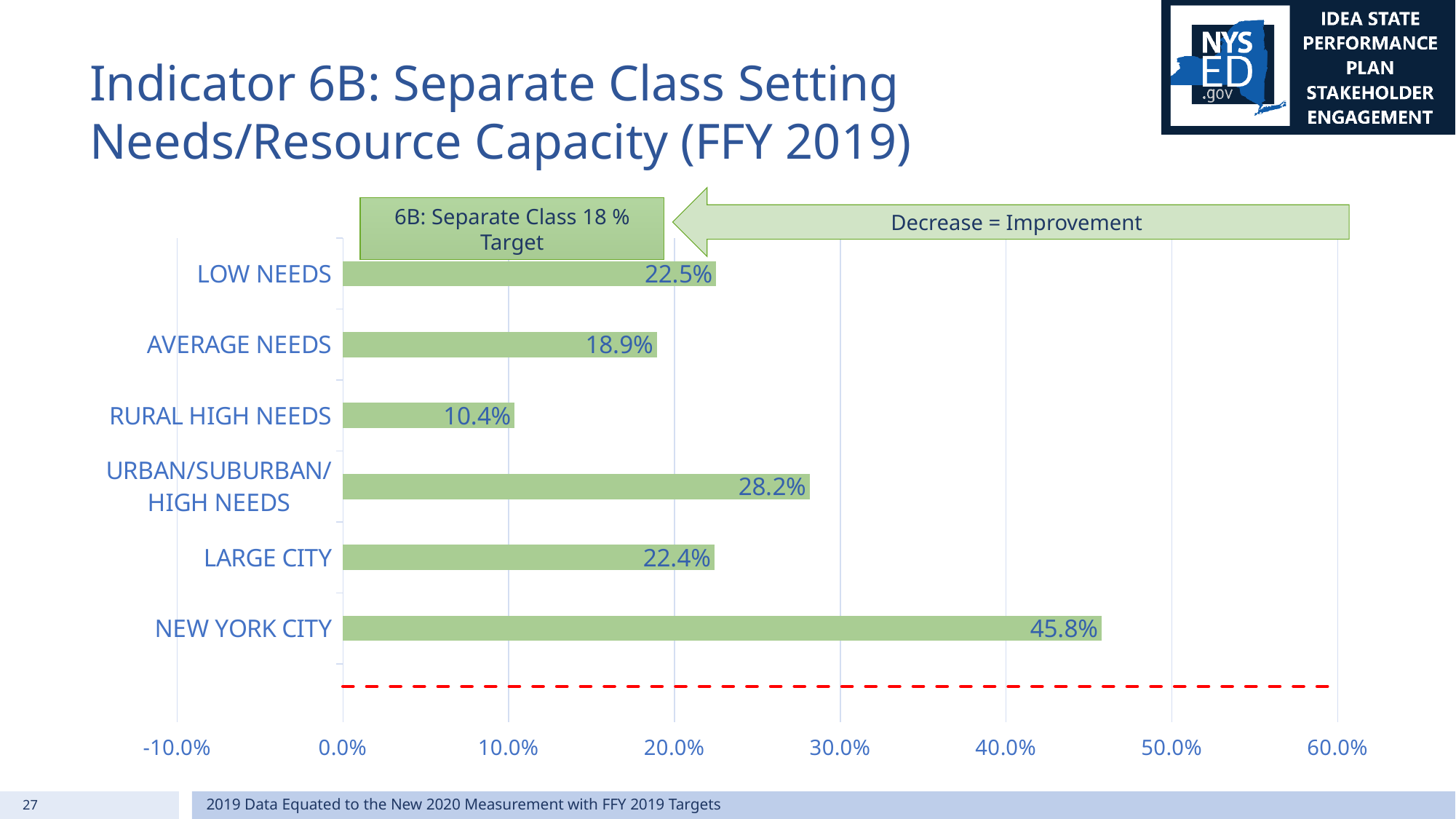
Which category has the highest value? NEW YORK CITY What is the value for AVERAGE NEEDS? 18.9% Which is larger, the value for URBAN/SUBURBAN/HIGH NEEDS or the value for LOW NEEDS? URBAN/SUBURBAN/HIGH NEEDS What is the value for NEW YORK CITY? 45.8% What is the value for RURAL HIGH NEEDS? 10.4% Which category has the lowest value? RURAL HIGH NEEDS What kind of chart is shown on the slide? bar chart Is the value for AVERAGE NEEDS greater or less than 20.0%? less What is the value for URBAN/SUBURBAN/HIGH NEEDS? 28.2% How many categories are shown in the chart? 6 What target percentage is stated in the green box above the chart? 18 % What is the difference between the values for NEW YORK CITY and LARGE CITY? 23.4%